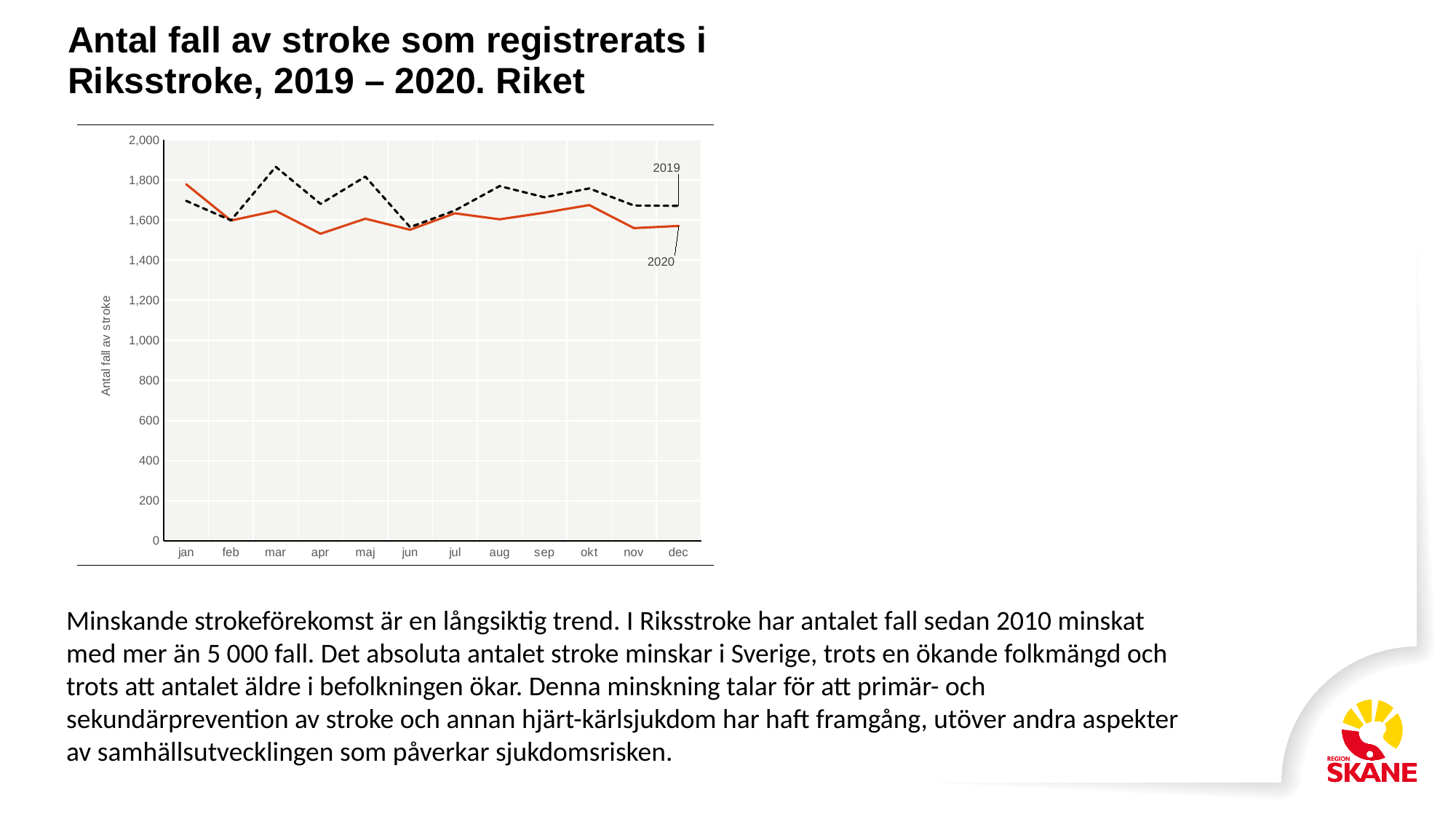
Is the value for 2019 in aug greater or less than 1,600? greater Which series has the higher value in jan, 2019 or 2020? 2020 Which series has the higher value in mar, 2019 or 2020? 2019 In which month does the 2019 series reach its highest value? mar How many series does the chart show? 2 In which month does the 2020 series reach its highest value? jan What kind of chart is shown on the slide? Line chart In which month does the 2019 series reach its lowest value? jun How many months are plotted along the x axis? 12 What is the label on the y axis of the chart? Antal fall av stroke Is the value for 2020 in apr greater or less than 1,600? less Is the value for 2019 in mar greater or less than 1,800? greater